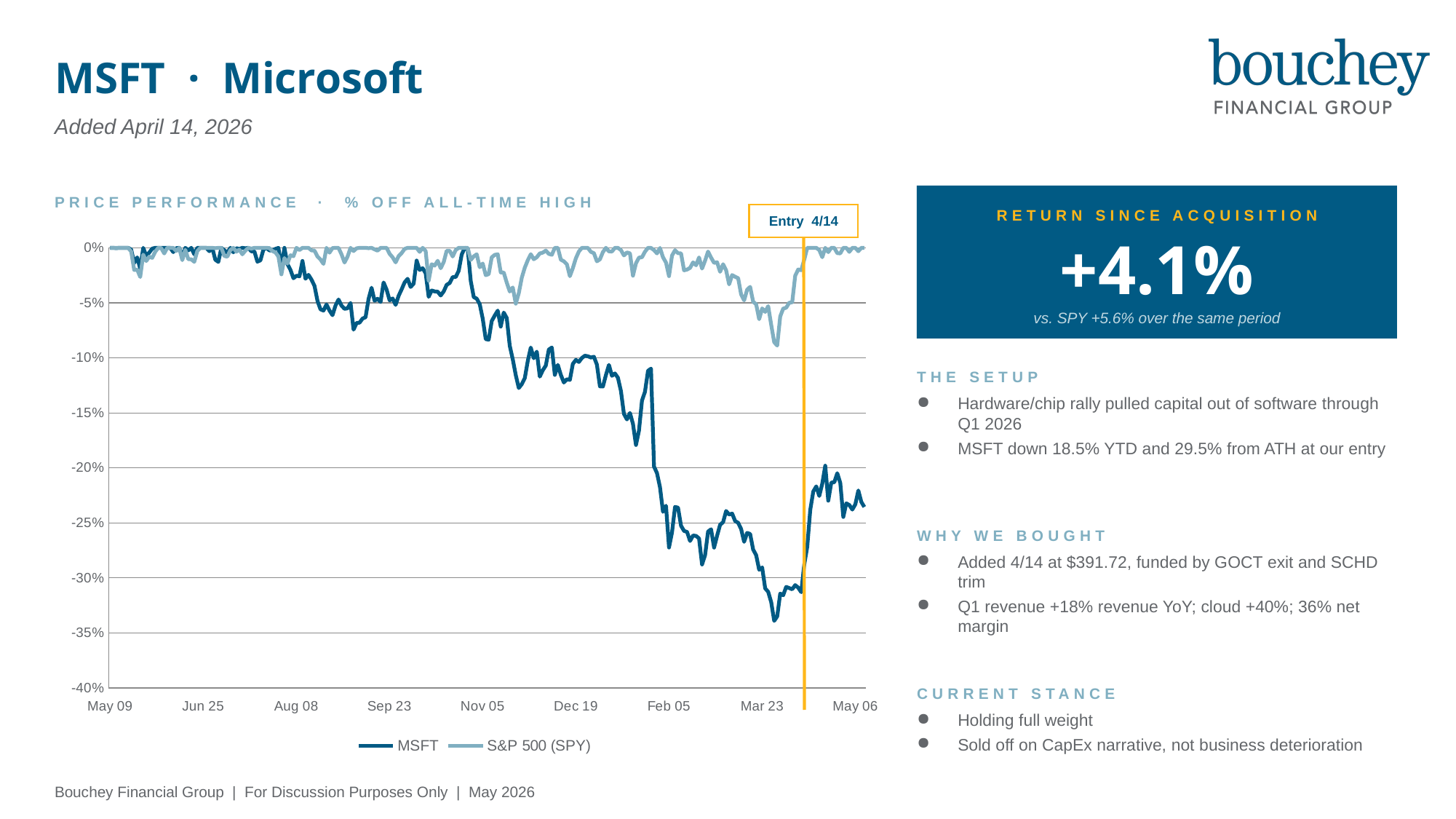
What are the two series named in the chart's legend? MSFT and S&P 500 (SPY) What is the title of the chart? PRICE PERFORMANCE · % OFF ALL-TIME HIGH Is the value for S&P 500 (SPY) at Feb 05 greater or less than -5%? greater Does the MSFT line generally rise or fall between Nov 05 and Mar 23? fall How many series does the chart's legend list? 2 At Sep 23, which series has the higher value, MSFT or S&P 500 (SPY)? S&P 500 (SPY) Is the value for MSFT at Feb 05 greater or less than -20%? less Is the value for MSFT at Dec 19 greater or less than -5%? less Which series reaches the lowest value anywhere on the chart? MSFT At Feb 05, which series has the higher value, MSFT or S&P 500 (SPY)? S&P 500 (SPY) What kind of chart is shown on the slide? Line chart How many date labels are shown along the x axis of the chart? 9